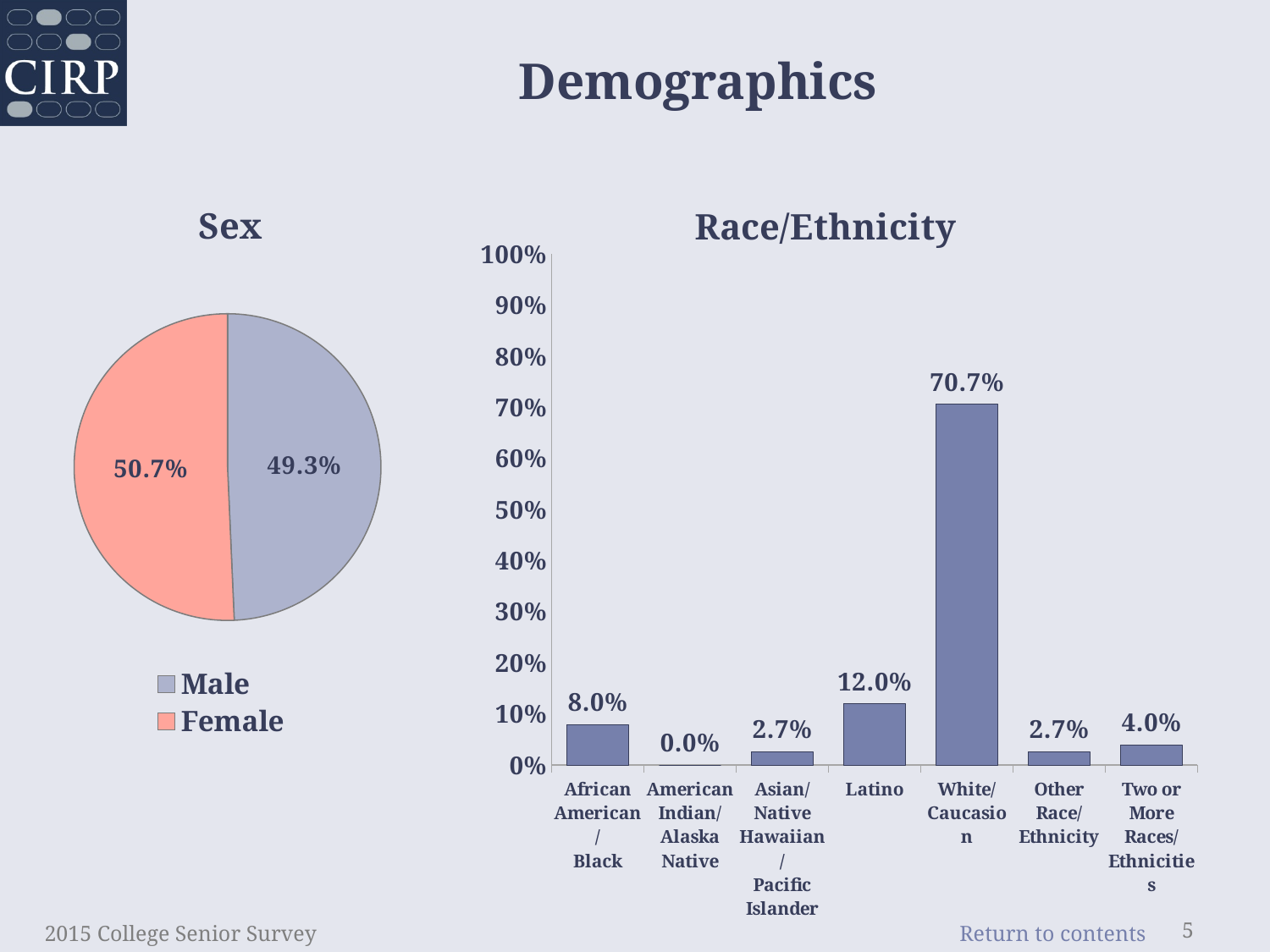
In the Race/Ethnicity chart, what is the value for Latino? 12.0% In the Sex pie chart, how many entries does the legend list? 2 What kind of chart is the Race/Ethnicity chart? Bar chart In the Sex pie chart, what percentage is Male? 49.3% What kind of chart is the Sex chart? Pie chart In the Sex pie chart, which slice is larger, Male or Female? Female In the Race/Ethnicity chart, how many categories are shown on the x axis? 7 In the Race/Ethnicity chart, which category has the highest value? White/Caucasian In the Race/Ethnicity chart, what is the difference between White/Caucasian and Latino? 58.7% In the Race/Ethnicity chart, what is the value for White/Caucasian? 70.7% In the Race/Ethnicity chart, which category has the lowest value? American Indian/Alaska Native In the Sex pie chart, what percentage is Female? 50.7%